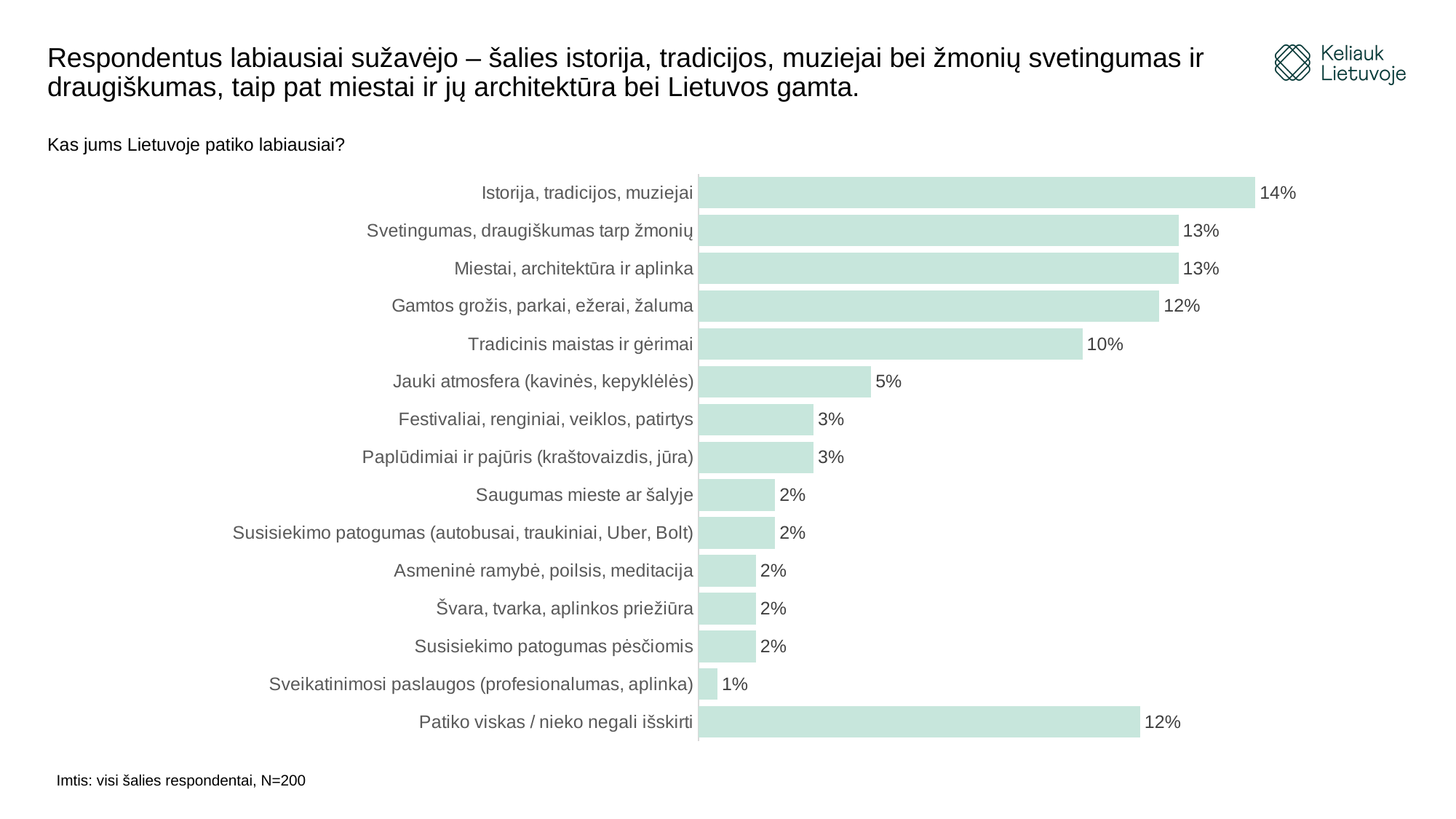
What is the value for "Jauki atmosfera (kavinės, kepyklėlės)"? 5% What is the difference between the values for "Istorija, tradicijos, muziejai" and "Tradicinis maistas ir gėrimai"? 4 percentage points What kind of chart is shown on the slide? Bar chart Which is larger: the value for "Tradicinis maistas ir gėrimai" or for "Jauki atmosfera (kavinės, kepyklėlės)"? Tradicinis maistas ir gėrimai What sample size (N) is stated below the chart? N=200 What is the survey question shown above the chart? Kas jums Lietuvoje patiko labiausiai? What is the value for "Patiko viskas / nieko negali išskirti"? 12% Which category has the highest value? Istorija, tradicijos, muziejai What is the value for "Tradicinis maistas ir gėrimai"? 10% How many categories are shown in the chart? 15 What is the value for "Istorija, tradicijos, muziejai"? 14% Which category has the lowest value? Sveikatinimosi paslaugos (profesionalumas, aplinka)